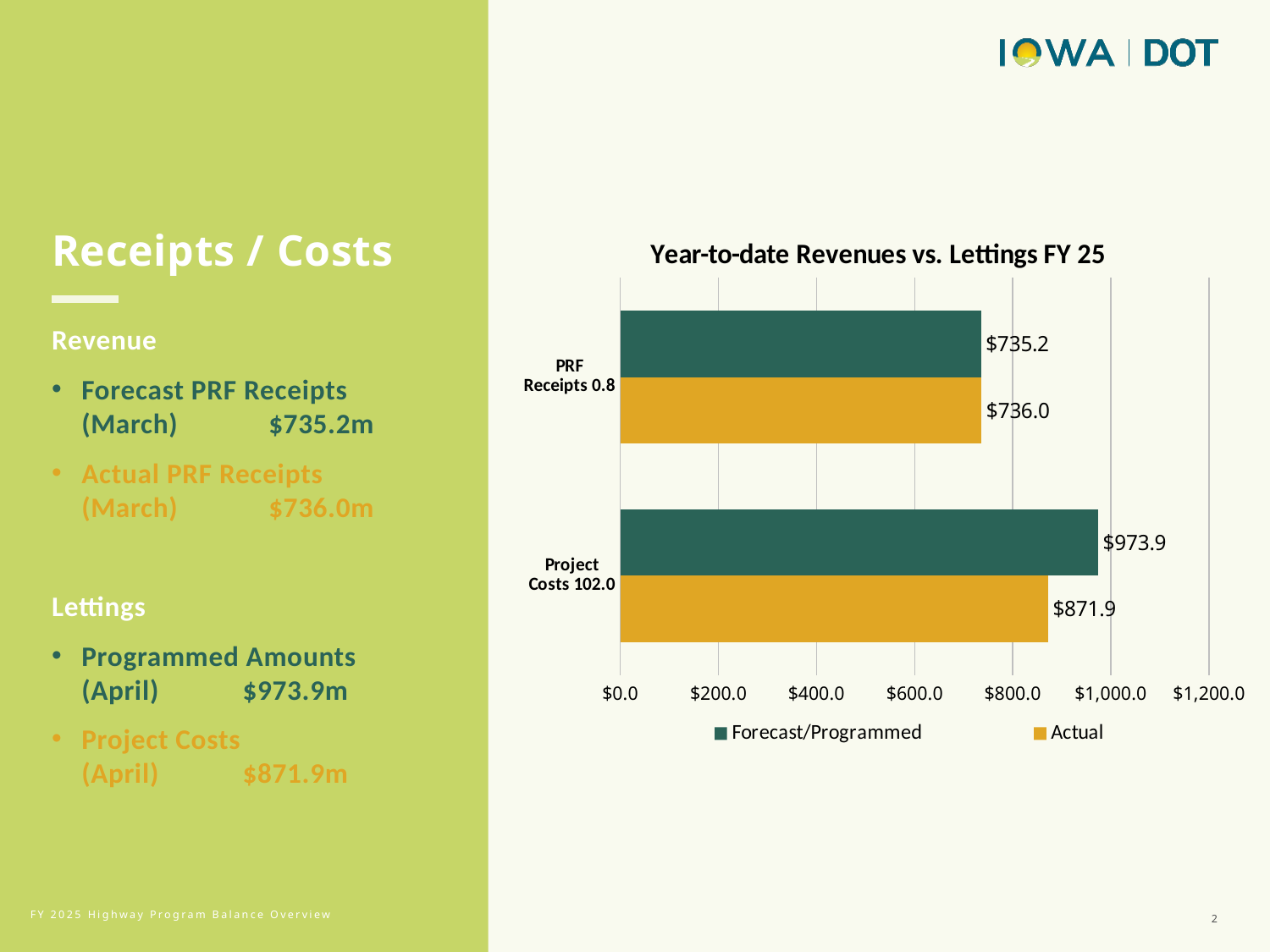
In the chart, what is the Forecast/Programmed value for Project Costs? $973.9 For Project Costs, which is larger: the Forecast/Programmed value or the Actual value? Forecast/Programmed How many categories are shown on the chart's vertical axis? 2 In the chart, what is the difference between the Actual and Forecast/Programmed values for PRF Receipts? 0.8 In the chart, what is the difference between the Forecast/Programmed and Actual values for Project Costs? 102.0 How many series does the chart's legend list? 2 In the chart, what is the Actual value for PRF Receipts? $736.0 In the chart, what is the Forecast/Programmed value for PRF Receipts? $735.2 In the chart, what is the Actual value for Project Costs? $871.9 Is the Actual value for Project Costs greater or less than $800.0? greater What type of chart is shown on the slide? Bar chart Which bar in the chart has the highest value? Forecast/Programmed for Project Costs ($973.9)